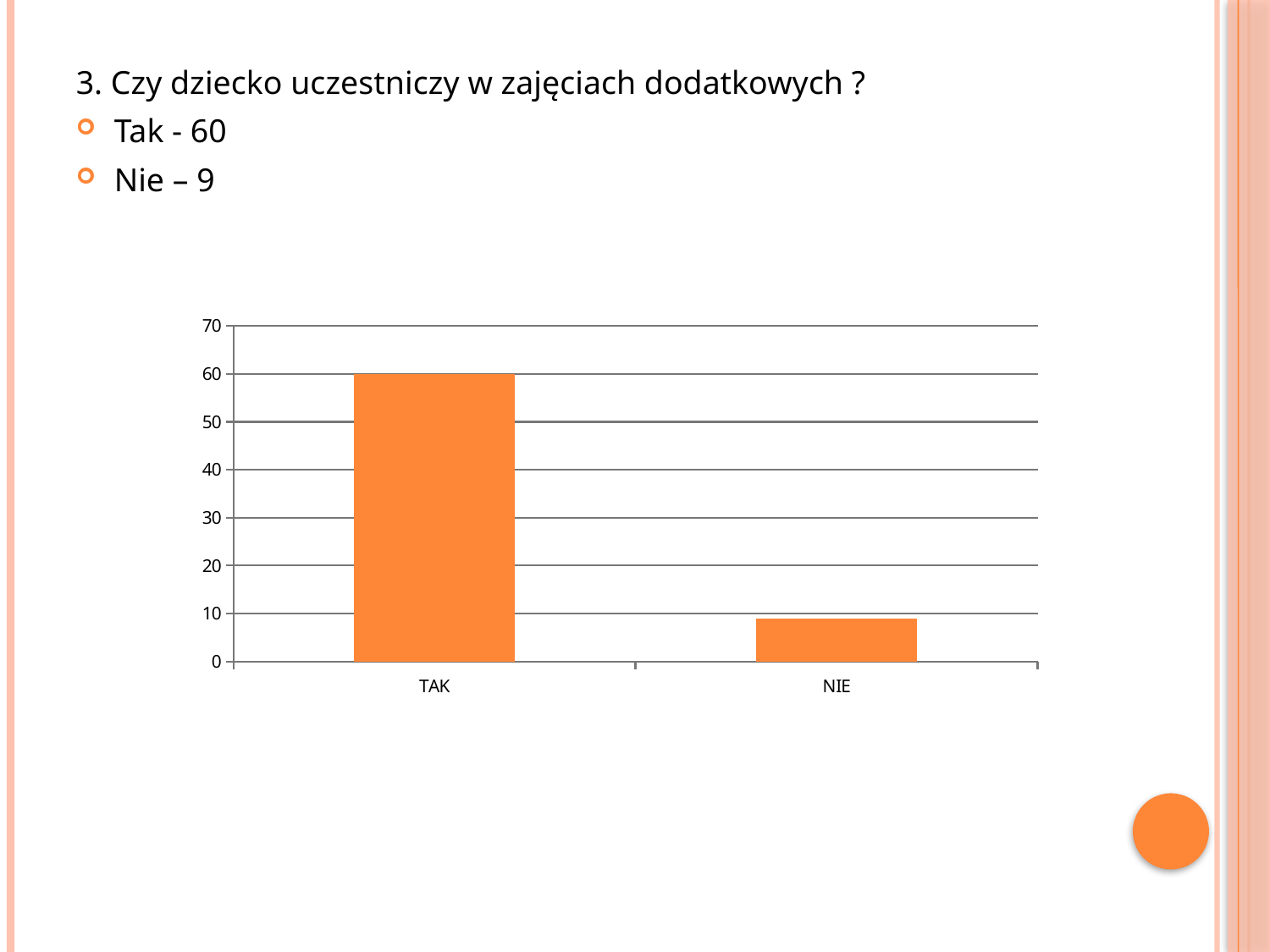
What is the total of the values for TAK and NIE? 69 Is the value for TAK greater or less than 50? greater What is the maximum value shown on the y axis of the chart? 70 Which is larger, the value for TAK or the value for NIE? TAK What kind of chart is shown on the slide? bar chart Which category has the highest value in the chart? TAK What is the value for NIE in the bar chart? 9 What is the difference between the values for TAK and NIE? 51 What is the value for TAK in the bar chart? 60 Which category has the lowest value in the chart? NIE Is the value for NIE greater or less than 10? less How many categories are shown on the x axis of the chart? 2